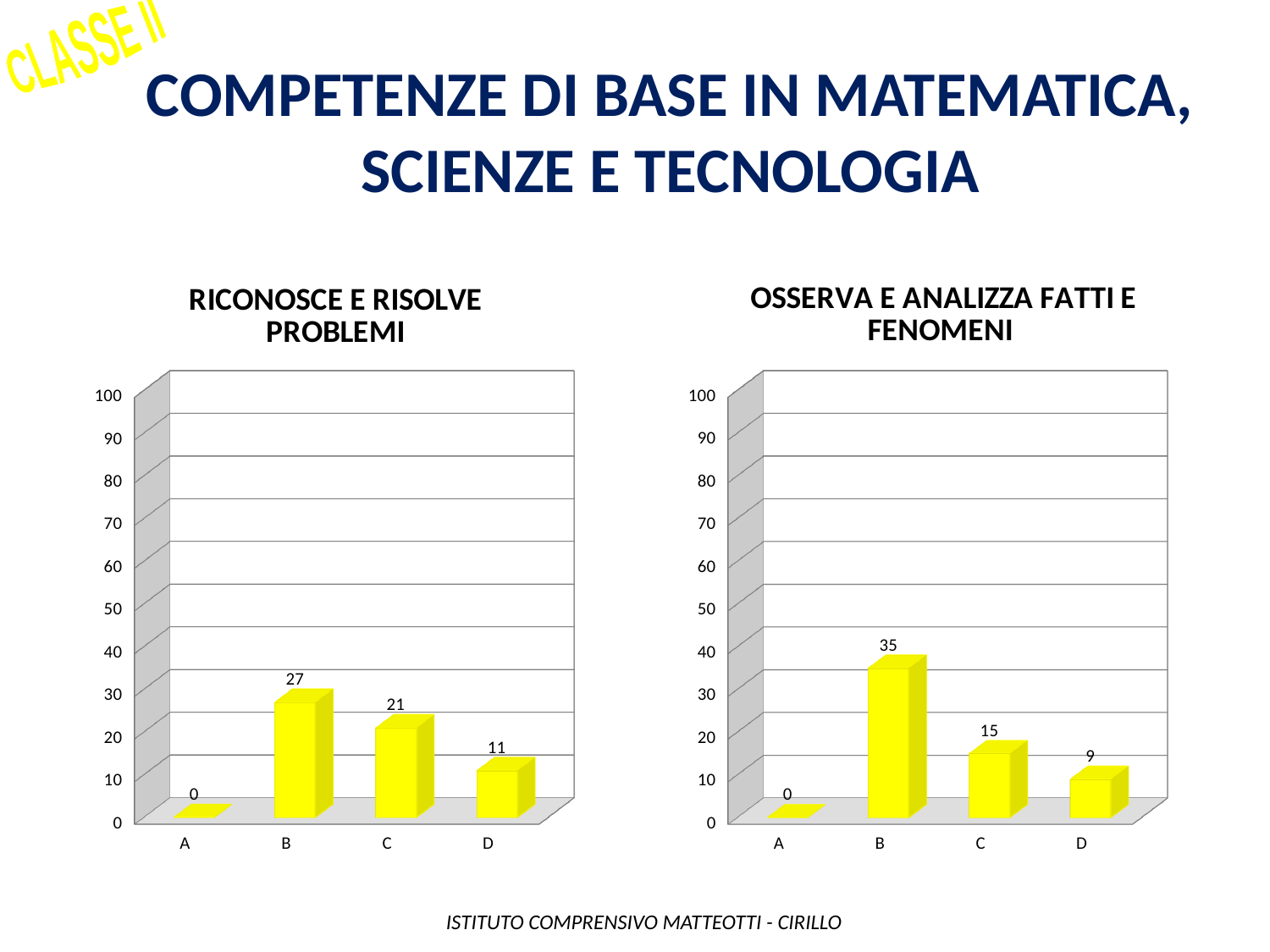
In the 'RICONOSCE E RISOLVE PROBLEMI' chart, which category has the lowest value? A In the 'OSSERVA E ANALIZZA FATTI E FENOMENI' chart, which category has the highest value? B In the 'RICONOSCE E RISOLVE PROBLEMI' chart, what is the value for category D? 11 In the 'RICONOSCE E RISOLVE PROBLEMI' chart, is the value for B greater or less than 20? greater In the 'OSSERVA E ANALIZZA FATTI E FENOMENI' chart, what is the difference between the values for B and D? 26 In the 'RICONOSCE E RISOLVE PROBLEMI' chart, what is the value for category B? 27 How many categories are shown on the x axis of the 'OSSERVA E ANALIZZA FATTI E FENOMENI' chart? 4 In the 'RICONOSCE E RISOLVE PROBLEMI' chart, what is the difference between the values for B and C? 6 In the 'OSSERVA E ANALIZZA FATTI E FENOMENI' chart, which is larger, the value for C or the value for D? C In the 'OSSERVA E ANALIZZA FATTI E FENOMENI' chart, what is the value for category C? 15 In the 'OSSERVA E ANALIZZA FATTI E FENOMENI' chart, do the values rise or fall from category B to category D? Fall What kind of chart is the 'RICONOSCE E RISOLVE PROBLEMI' chart? Bar chart